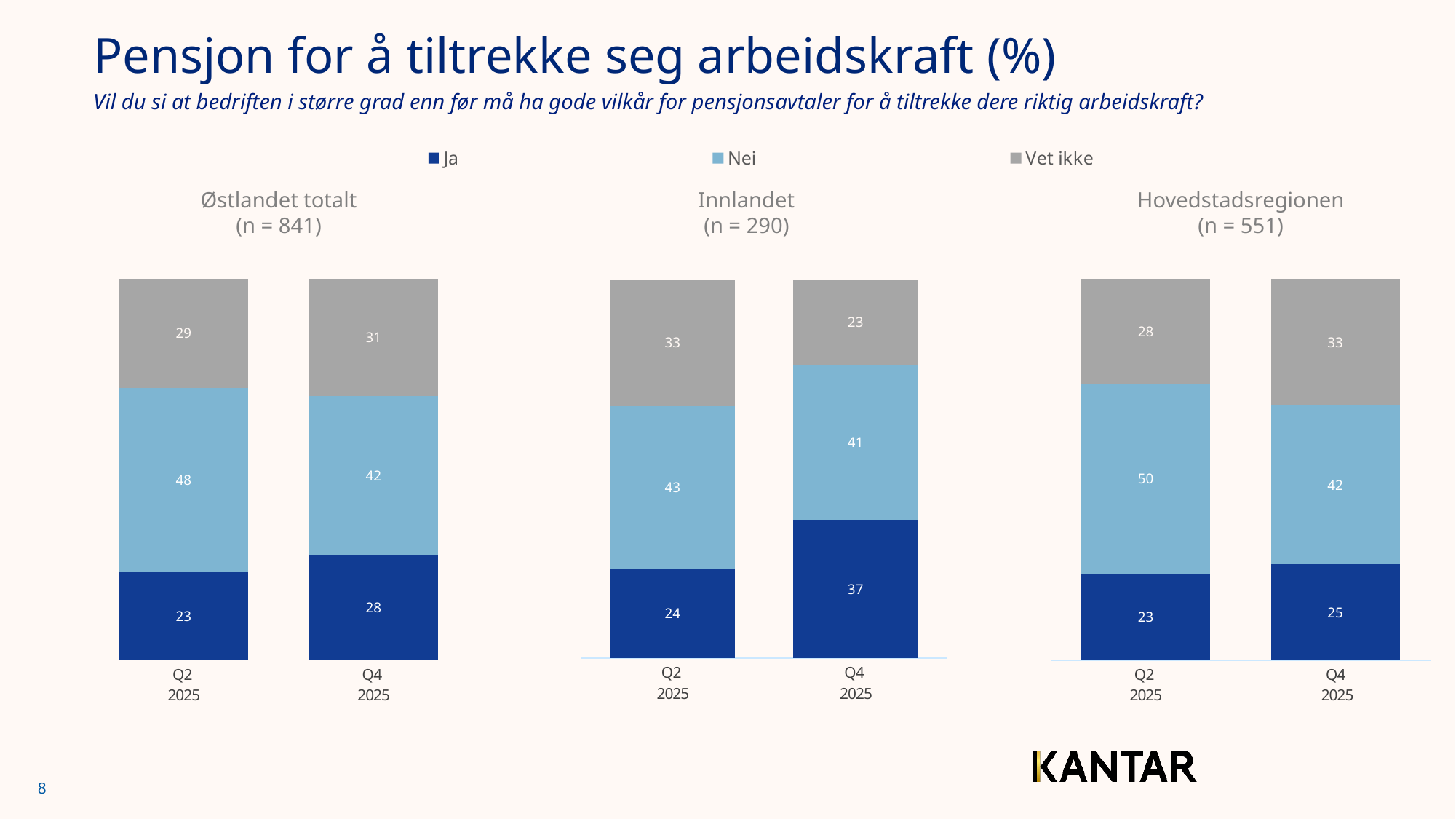
How many series does the legend list? 3 What is the sample size (n) shown for the Hovedstadsregionen chart? 551 In the Innlandet chart, does the Ja value rise or fall from Q2 2025 to Q4 2025? Rise In the Innlandet chart, which segment is the smallest in the Q4 2025 bar? Vet ikke What kind of chart is used on this slide? Stacked bar chart In the Innlandet chart, what is the value for Ja in Q4 2025? 37 In the Hovedstadsregionen chart, what is the value for Nei in Q2 2025? 50 In the Østlandet totalt chart, what is the value for Vet ikke in Q4 2025? 31 In the Østlandet totalt chart, what is the total of the Q2 2025 stacked bar? 100 In the Østlandet totalt chart, what is the difference between the Nei values for Q2 2025 and Q4 2025? 6 In the Hovedstadsregionen chart, which segment is the largest in the Q2 2025 bar? Nei In the Innlandet chart, which is larger: Ja in Q2 2025 or Ja in Q4 2025? Ja in Q4 2025